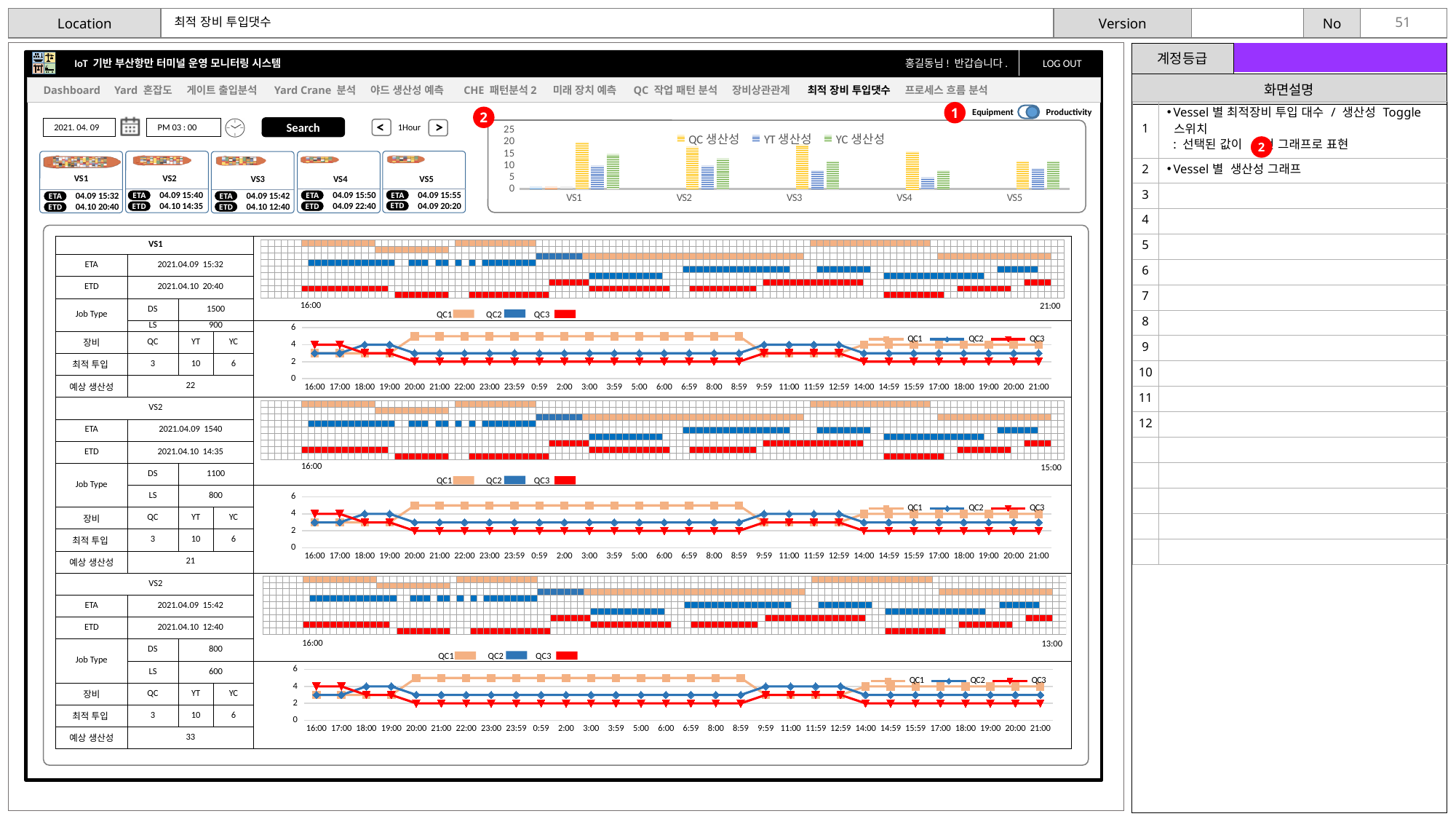
In the first line chart under the VS1 table, which series has the highest value between 20:00 and 8:59? QC1 In the top bar chart, which series has the highest value for VS1? QC 생산성 What kind of chart is the chart at the top of the dashboard showing VS1 to VS5? bar chart In the first line chart under the VS1 table, is the QC1 value at 23:00 greater or less than 4? greater In the top bar chart, is the YT 생산성 value for VS4 greater or less than 10? less In the top bar chart, is the QC 생산성 value for VS5 greater or less than 15? less What kind of chart is the first time-series chart under the VS1 table (with QC1, QC2, QC3)? line chart How many vessel categories are shown on the x axis of the top bar chart? 5 In the top bar chart, which is larger for VS3: QC 생산성 or YT 생산성? QC 생산성 In the top bar chart, which vessel has the lowest YT 생산성? VS4 How many series does the legend of the top bar chart (VS1 to VS5) list? 3